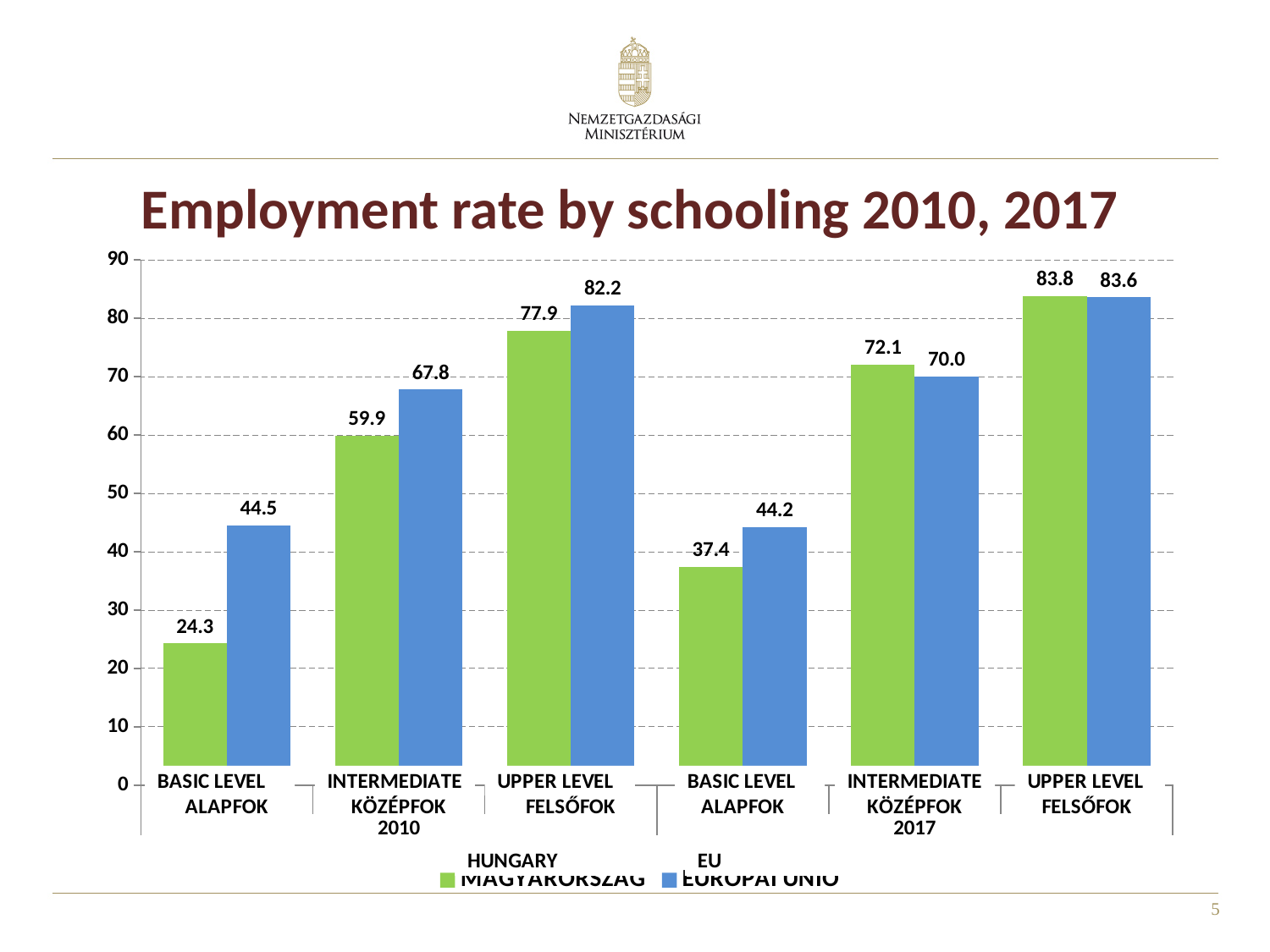
What is the employment rate for the EU at upper level in 2017? 83.6 What kind of chart is shown on the slide? Bar chart Which is larger in 2017 at intermediate level: Hungary or the EU? Hungary What is the employment rate for the EU at intermediate level in 2010? 67.8 How many series does the legend list? 2 Which bar has the highest value on the chart? Hungary, upper level 2017 (83.8) What is the employment rate for Hungary at basic level in 2010? 24.3 What is the title of the chart? Employment rate by schooling 2010, 2017 Which bar has the lowest value on the chart? Hungary, basic level 2010 (24.3) What is the difference between Hungary's basic level employment rate in 2017 and in 2010? 13.1 What is the employment rate for Hungary at intermediate level in 2017? 72.1 What is the difference between the EU and Hungary employment rates at basic level in 2010? 20.2